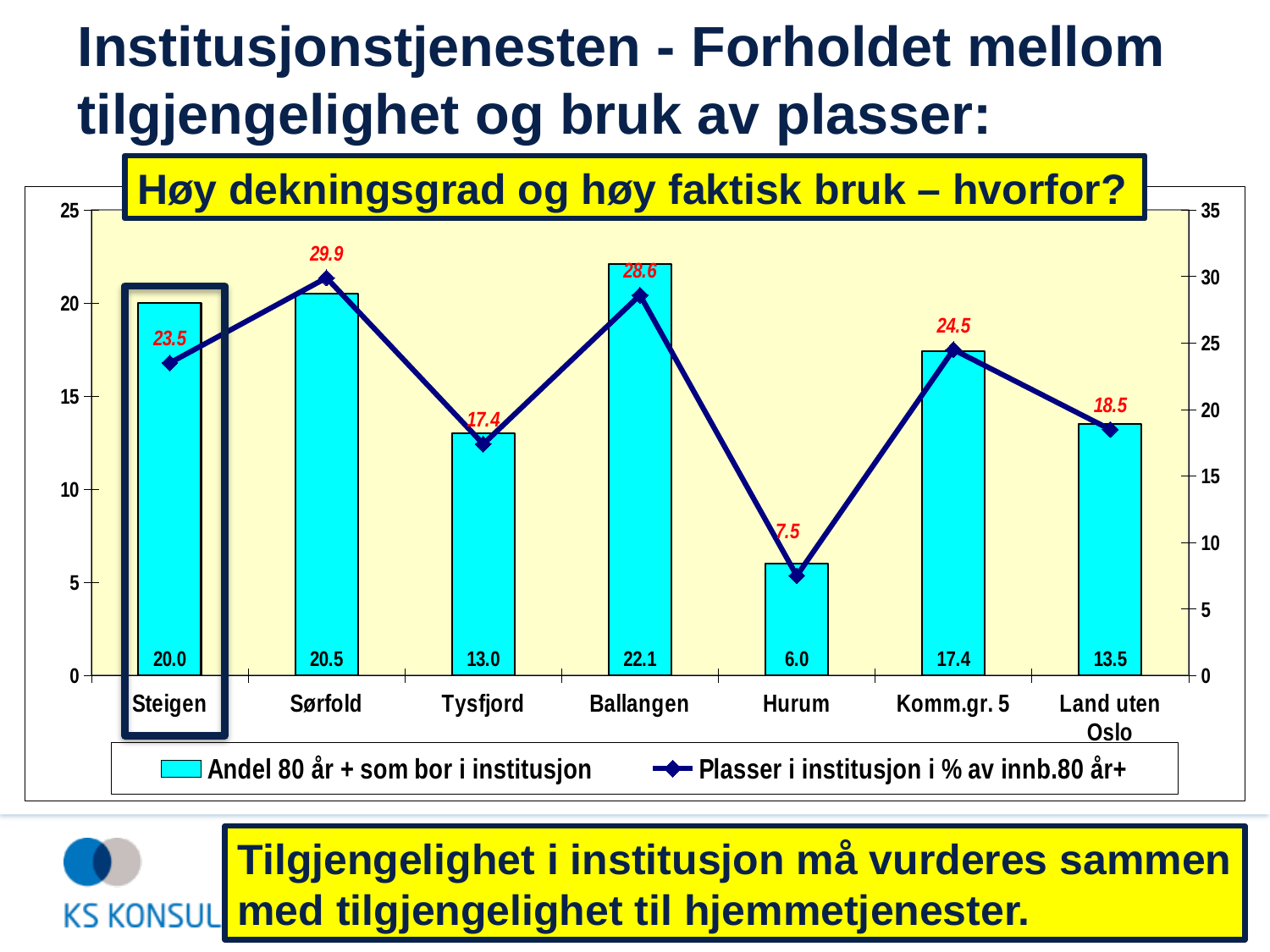
Which category has the lowest value for 'Andel 80 år + som bor i institusjon'? Hurum Which has a higher 'Plasser i institusjon i % av innb.80 år+' value, Komm.gr. 5 or Land uten Oslo? Komm.gr. 5 What is the difference between the 'Andel 80 år + som bor i institusjon' values for Ballangen and Hurum? 16.1 What kind of chart is this? Combined bar and line chart Which category is highlighted with a dark rectangle on the chart? Steigen What is the value of 'Plasser i institusjon i % av innb.80 år+' for Sørfold? 29.9 What is the value of 'Andel 80 år + som bor i institusjon' for Ballangen? 22.1 How many categories are shown on the x axis? 7 What is the value of 'Andel 80 år + som bor i institusjon' for Tysfjord? 13.0 How many series does the legend list? 2 Which category has the highest value for 'Plasser i institusjon i % av innb.80 år+'? Sørfold What is the value of 'Plasser i institusjon i % av innb.80 år+' for Steigen? 23.5